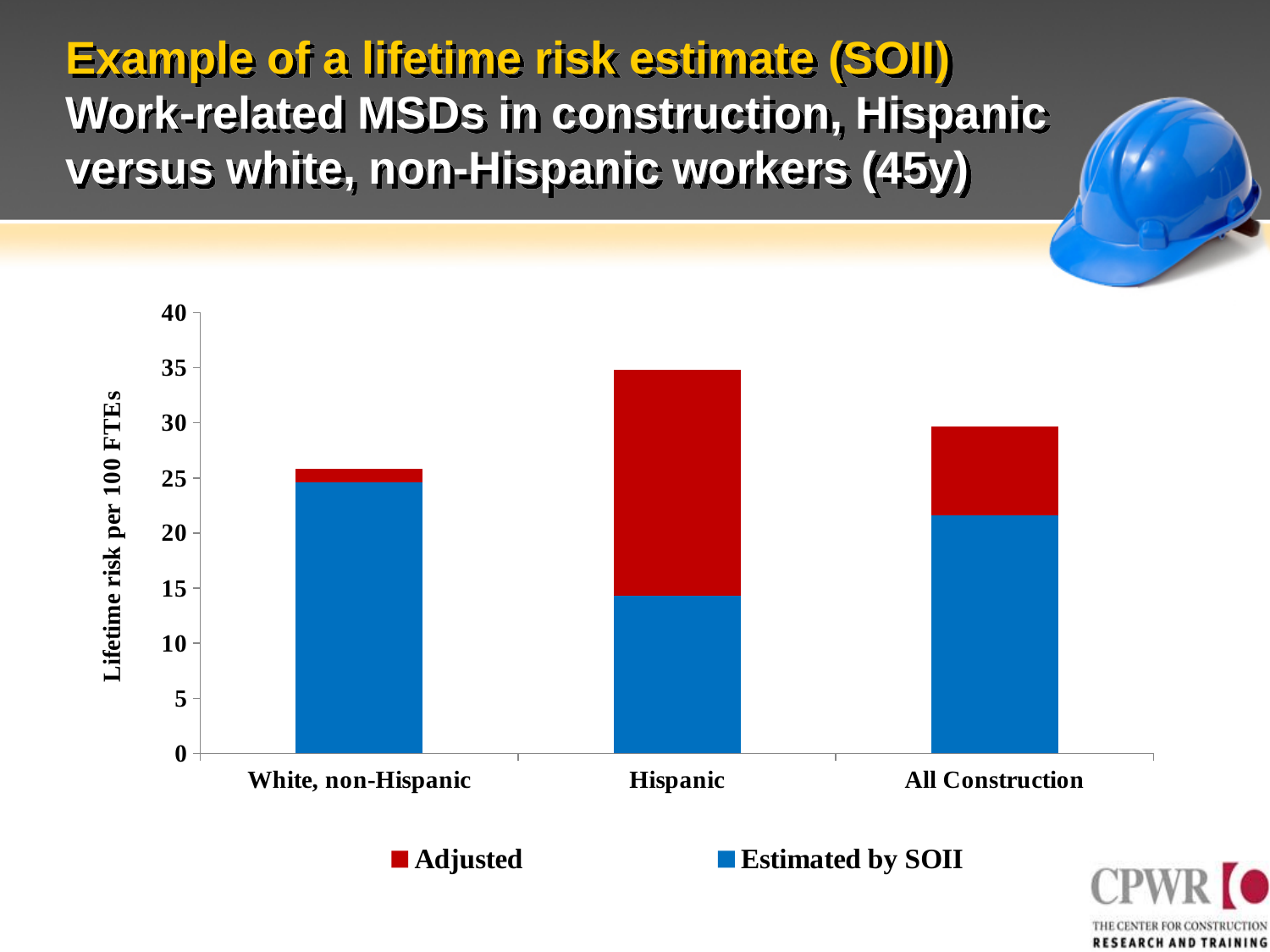
Is the total lifetime risk for Hispanic workers greater or less than 30? greater What is the label of the y axis of the chart? Lifetime risk per 100 FTEs Which is larger: the total lifetime risk for Hispanic or for All Construction? Hispanic Which category has the lowest total lifetime risk in the chart? White, non-Hispanic How many categories are shown on the x axis of the chart? 3 How many series does the chart's legend list? 2 Which category has the highest total lifetime risk in the chart? Hispanic Is the 'Estimated by SOII' value for Hispanic workers greater or less than 20? less Which category has the largest 'Adjusted' portion? Hispanic Which category has the smallest 'Estimated by SOII' value? Hispanic Is the total lifetime risk for White, non-Hispanic workers greater or less than 30? less What kind of chart is shown on the slide? Stacked bar chart